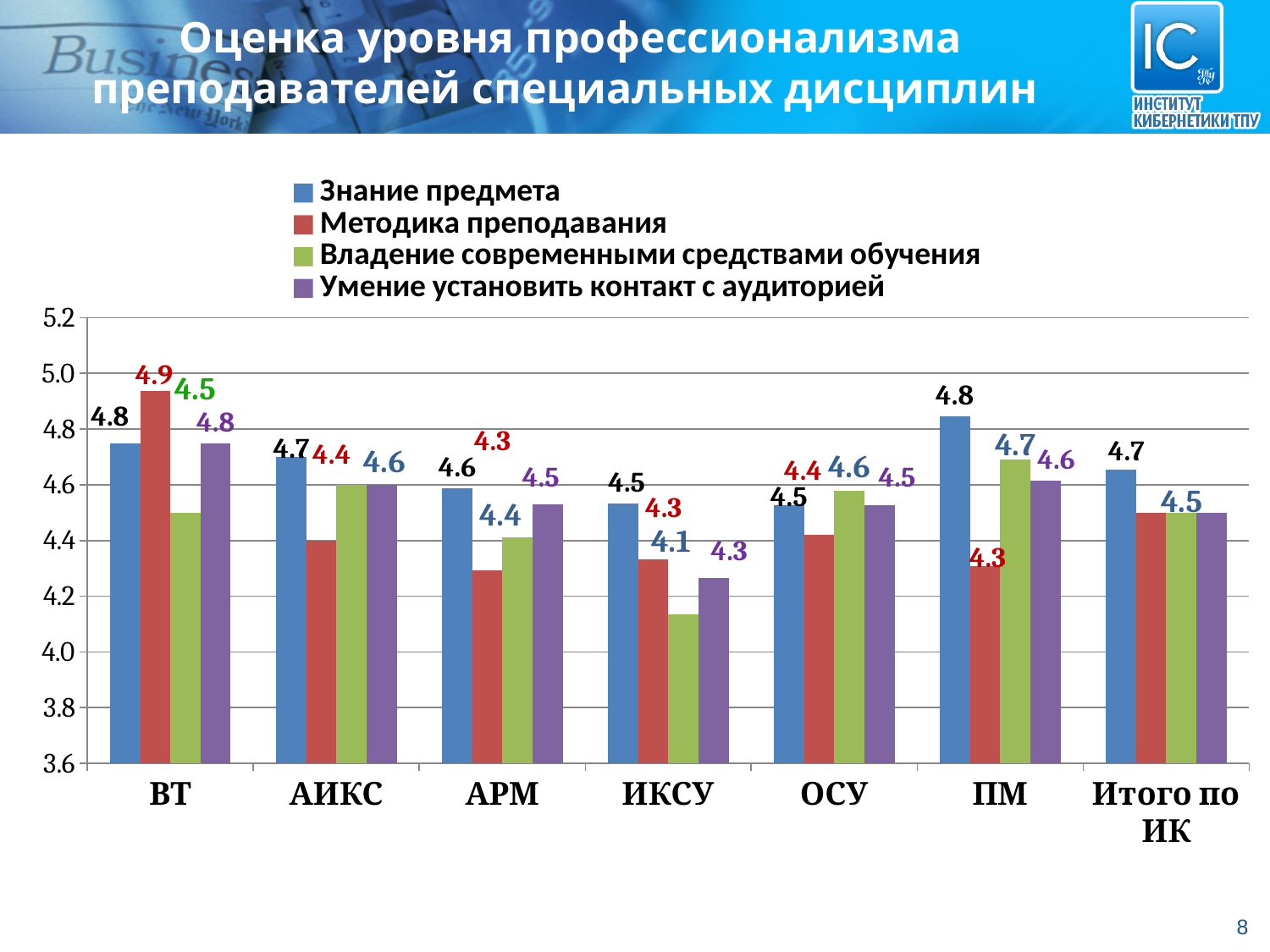
Which category has the lowest value for Владение современными средствами обучения? ИКСУ What is the value of Знание предмета for Итого по ИК? 4.7 Which is larger: Методика преподавания for ВТ or Методика преподавания for АИКС? ВТ For ПМ, what is the difference between Знание предмета and Методика преподавания? 0.5 How many series does the legend list? 4 What colour represents Умение установить контакт с аудиторией in the legend? purple What is the value of Владение современными средствами обучения for ИКСУ? 4.1 Is the value of Владение современными средствами обучения for ИКСУ greater or less than 4.2? less What kind of chart is shown on the slide? bar chart What is the value of Методика преподавания for ВТ? 4.9 Which category has the highest value for Методика преподавания? ВТ How many categories are shown on the x axis? 7